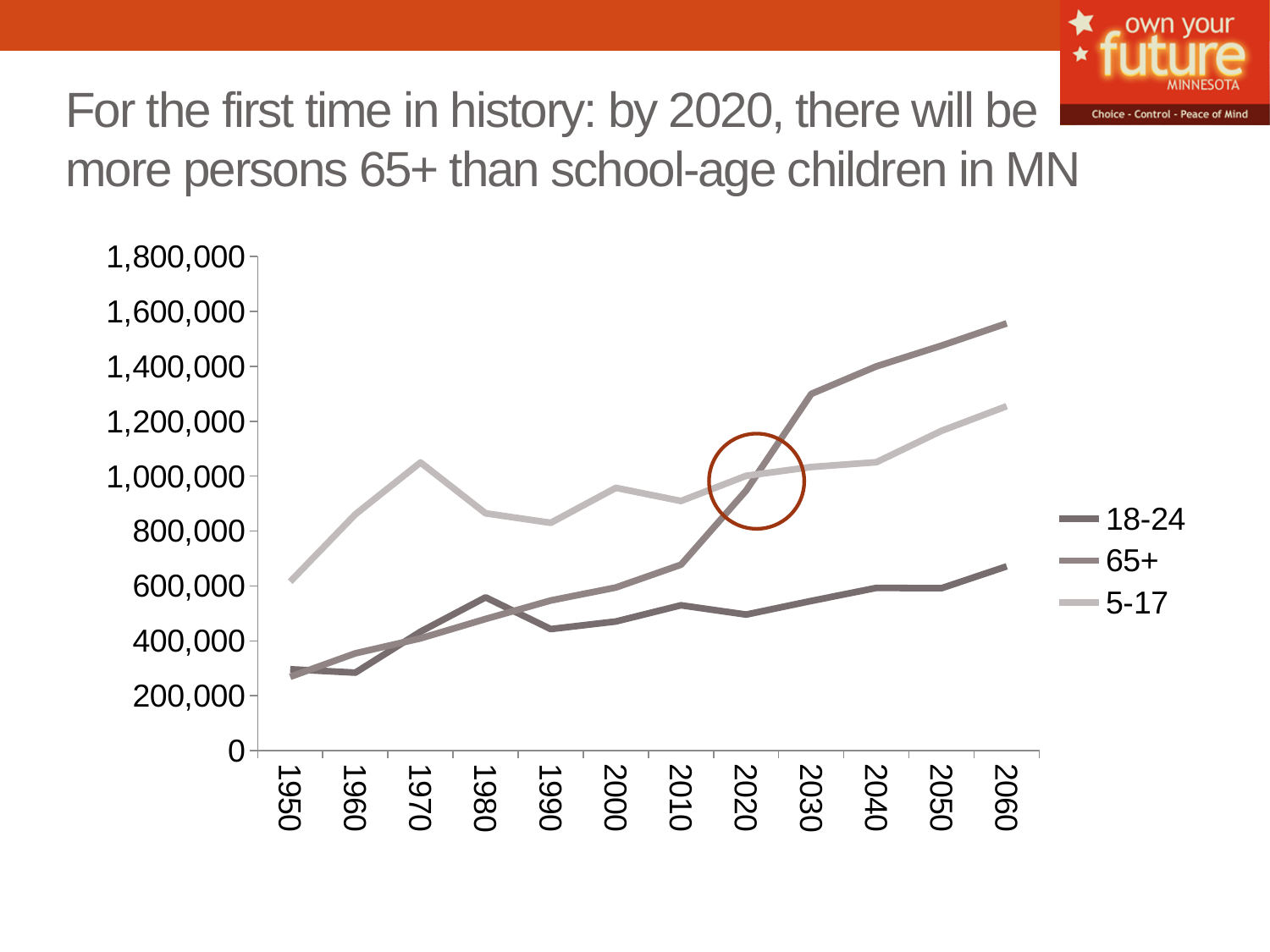
Does the 65+ series rise or fall from 1950 to 2060? rises Is the value for the 65+ series in 1950 greater or less than 400,000? less Which two series cross inside the circled area around 2020? 65+ and 5-17 Is the value for the 65+ series in 2060 greater or less than 1,400,000? greater Which series has the lowest value in 2060? 18-24 Which series has the highest value in 2060? 65+ How many series does the legend list? 3 In 2060, which is larger: the 65+ series or the 5-17 series? 65+ How many years are marked along the x axis? 12 In 2000, which is larger: the 5-17 series or the 65+ series? 5-17 Is the value for the 18-24 series in 2060 greater or less than 600,000? greater What kind of chart is shown on the slide? Line chart